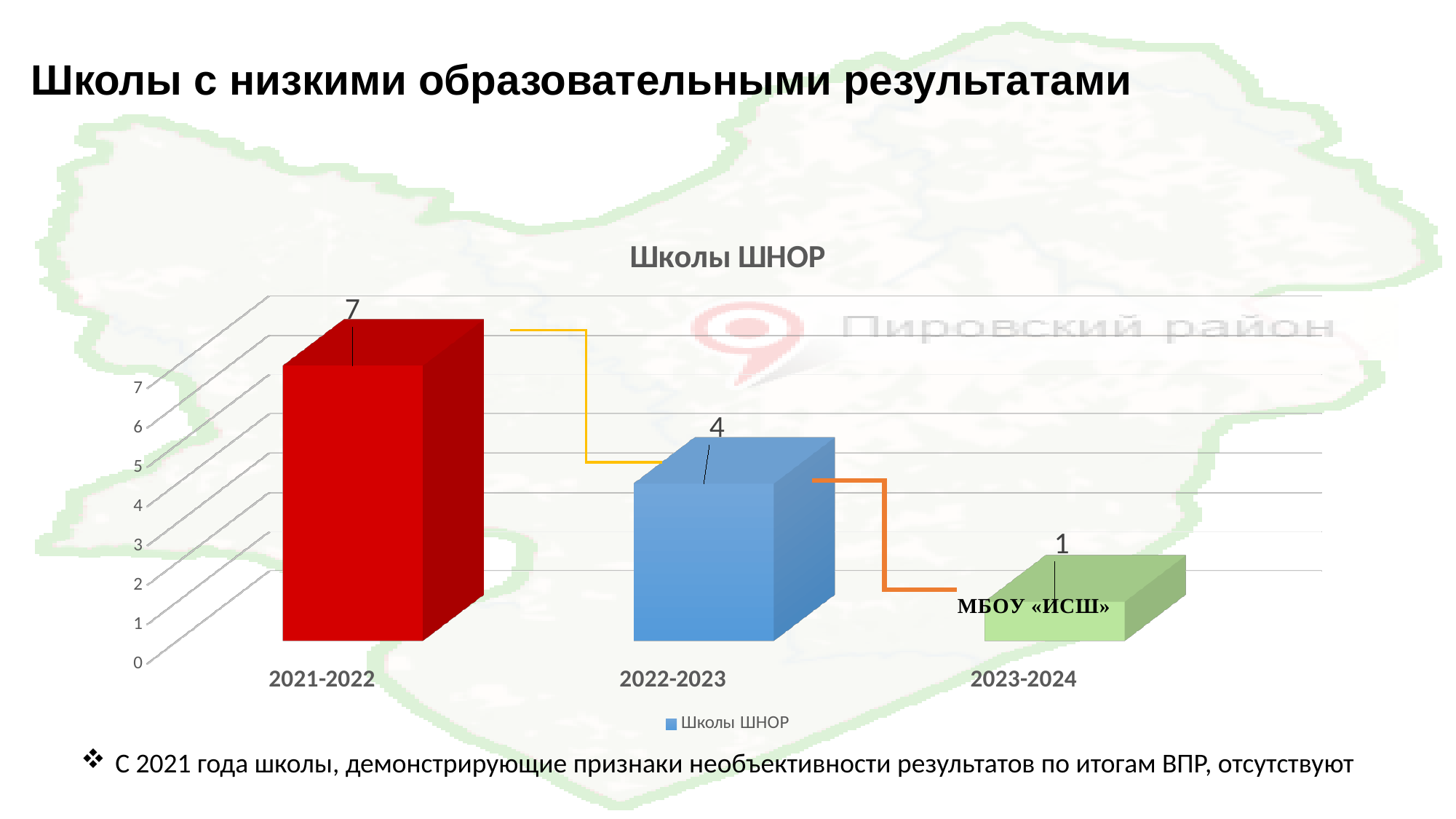
What is the value for 2022-2023 in the chart? 4 What kind of chart is shown? bar chart How many series does the legend list? 1 Which is larger, the value for 2021-2022 or the value for 2023-2024? 2021-2022 Do the values rise or fall from 2021-2022 to 2023-2024? fall What is the value for 2023-2024 in the chart? 1 What is the value for 2021-2022 in the chart? 7 What is the difference between the values for 2021-2022 and 2022-2023? 3 What is the difference between the values for 2022-2023 and 2023-2024? 3 Which category has the lowest value? 2023-2024 How many categories are shown on the x axis? 3 Which category has the highest value? 2021-2022